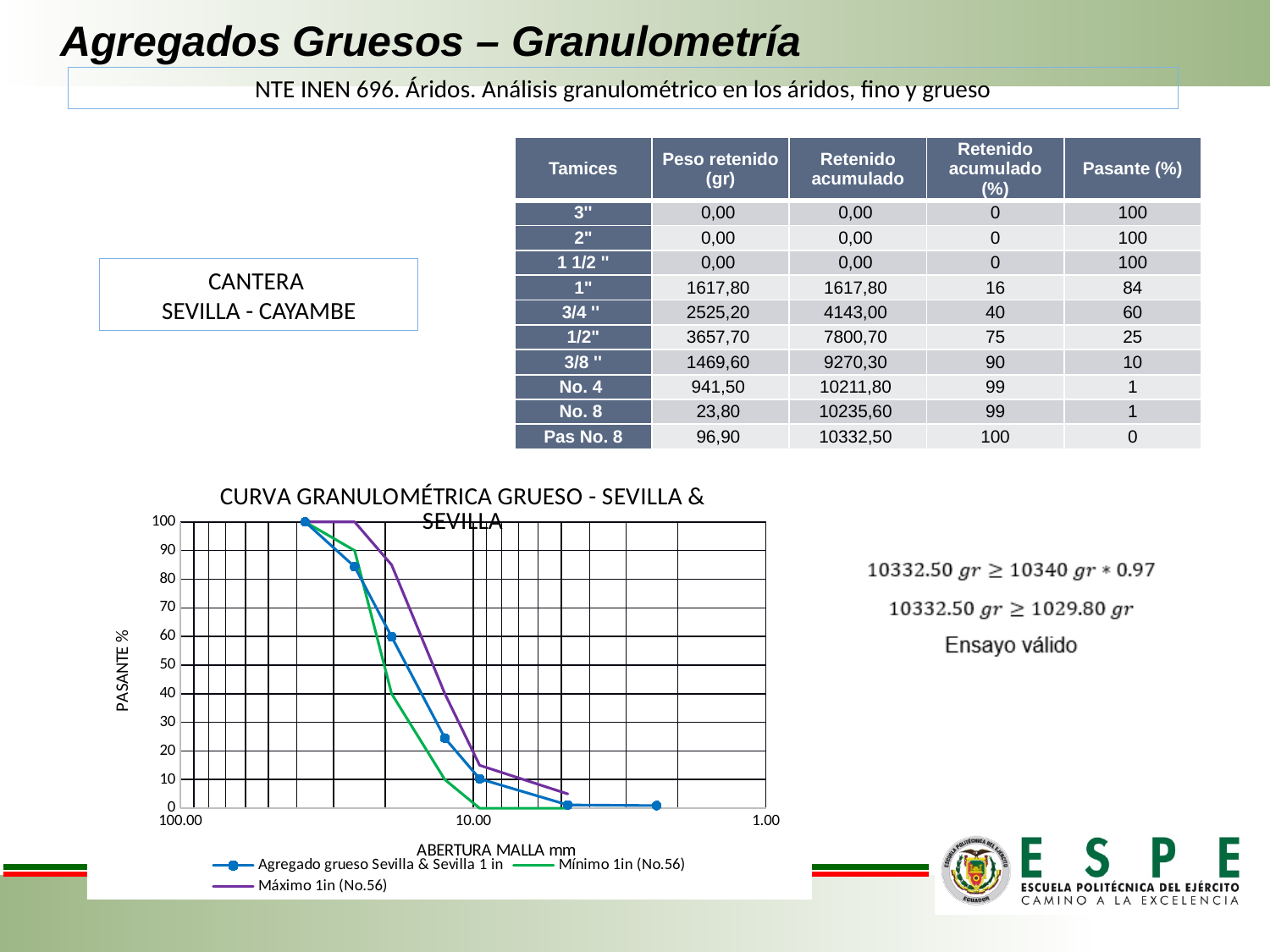
How many series does the legend of the chart list? 3 Is the highest value of the 'Agregado grueso Sevilla & Sevilla 1 in' series greater or less than 90? greater At an opening of 10.00 mm, is the value of the 'Mínimo 1in (No.56)' series greater or less than 10? less At an opening of 10.00 mm, is the value of the 'Máximo 1in (No.56)' series greater or less than 50? less Moving from left to right along the x axis, do the values of the 'Agregado grueso Sevilla & Sevilla 1 in' series rise or fall? fall How many marked data points does the 'Agregado grueso Sevilla & Sevilla 1 in' series have? 7 What is the highest tick value shown on the vertical axis of the chart? 100 What is the leftmost tick value shown on the horizontal axis of the chart? 100.00 Which series lies higher on the chart at an opening of 10.00 mm, 'Máximo 1in (No.56)' or 'Mínimo 1in (No.56)'? Máximo 1in (No.56) What is the label of the vertical axis of the chart? PASANTE % What is the title of the chart? CURVA GRANULOMÉTRICA GRUESO - SEVILLA & SEVILLA What kind of chart is shown on the slide? line chart